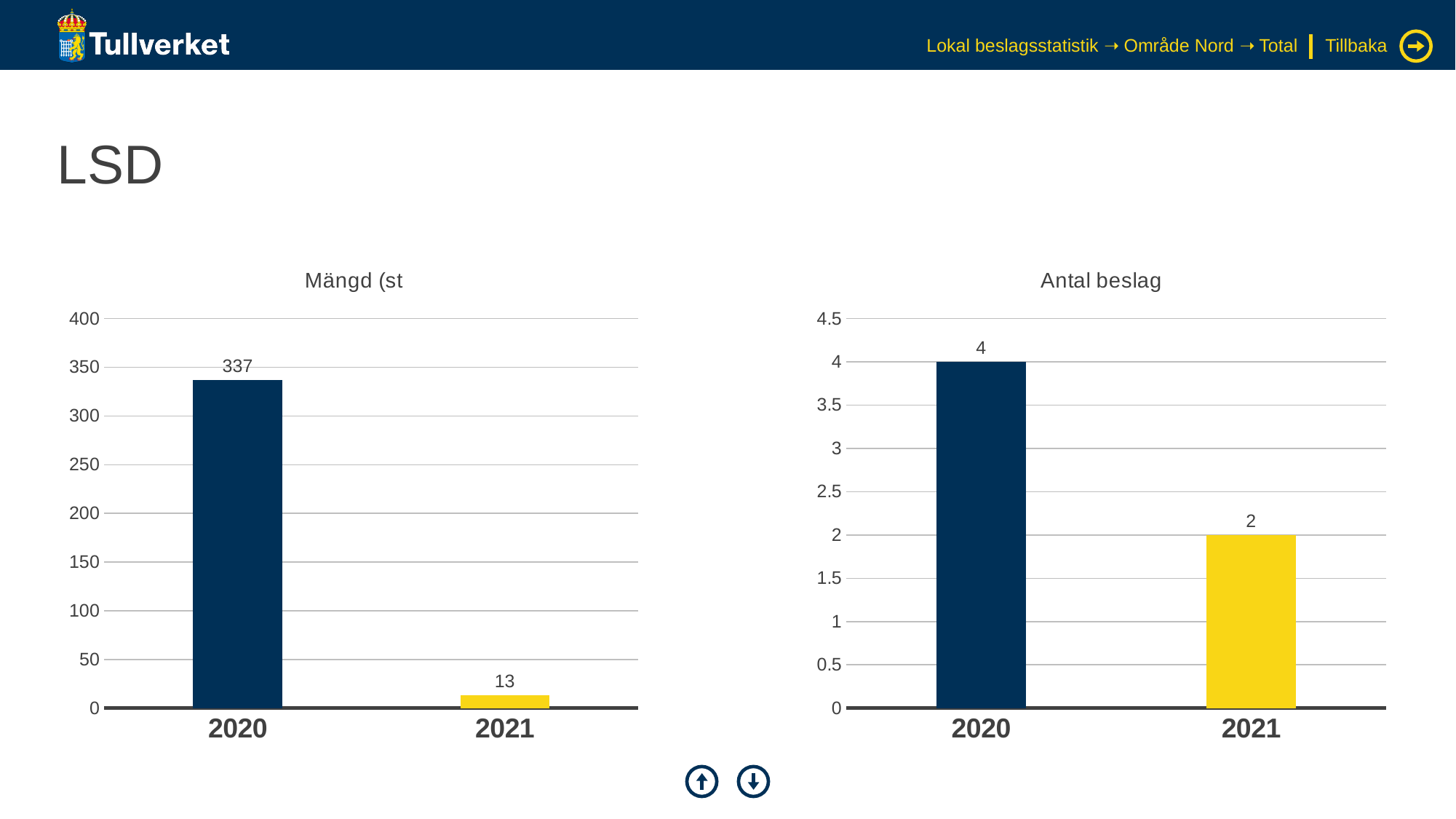
In the 'Mängd (st' chart, what is the value for 2021? 13 In the 'Antal beslag' chart, what is the value for 2020? 4 What kind of chart is the 'Antal beslag' chart? bar chart In the 'Antal beslag' chart, which year has the lowest value? 2021 In the 'Mängd (st' chart, do the values rise or fall from 2020 to 2021? fall In the 'Antal beslag' chart, what is the difference between the values for 2020 and 2021? 2 In the 'Mängd (st' chart, what is the value for 2020? 337 In the 'Antal beslag' chart, is the value for 2020 larger or smaller than the value for 2021? larger How many categories are shown on the x axis of the 'Mängd (st' chart? 2 In the 'Mängd (st' chart, which year has the highest value? 2020 In the 'Antal beslag' chart, what is the value for 2021? 2 In the 'Mängd (st' chart, what is the difference between the values for 2020 and 2021? 324